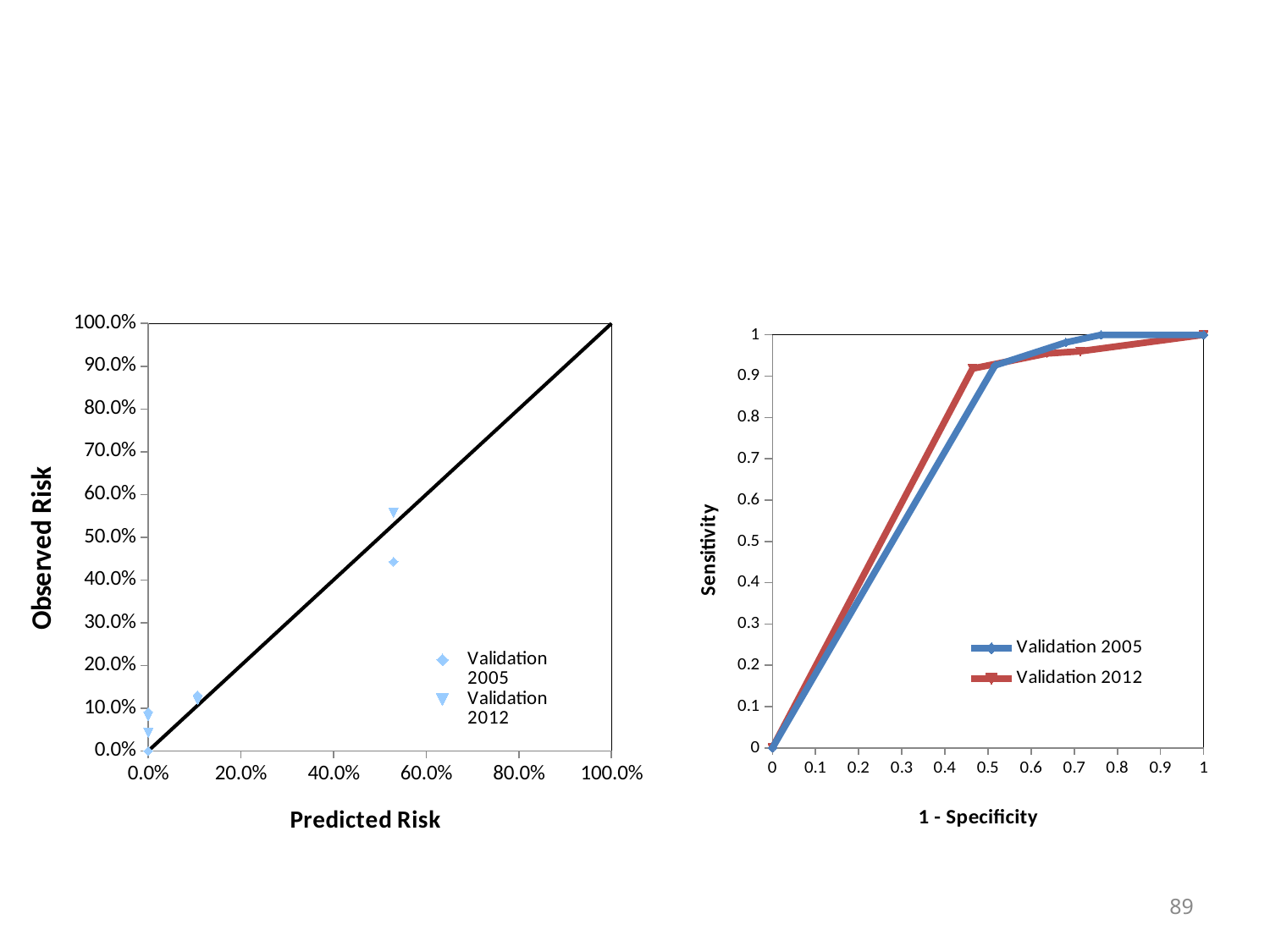
What kind of chart is the chart on the right of the slide (Sensitivity vs 1 - Specificity)? line chart What is the x-axis title of the left chart? Predicted Risk In the left chart, is the observed risk for the Validation 2012 point plotted at roughly 53% predicted risk greater or less than 50.0%? greater How many series does the legend of the right chart list? 2 In the right chart, which series is drawn in red? Validation 2012 In the left chart, at a predicted risk of roughly 53%, which series has the higher observed risk, Validation 2005 or Validation 2012? Validation 2012 What is the y-axis title of the right chart? Sensitivity How many series does the legend of the left chart list? 2 In the left chart, is the observed risk for the Validation 2005 point plotted at roughly 53% predicted risk greater or less than 50.0%? less In the right chart, does sensitivity rise or fall as 1 - Specificity increases from 0 to 1? rise What kind of chart is the chart on the left of the slide (Predicted Risk vs Observed Risk)? scatter chart